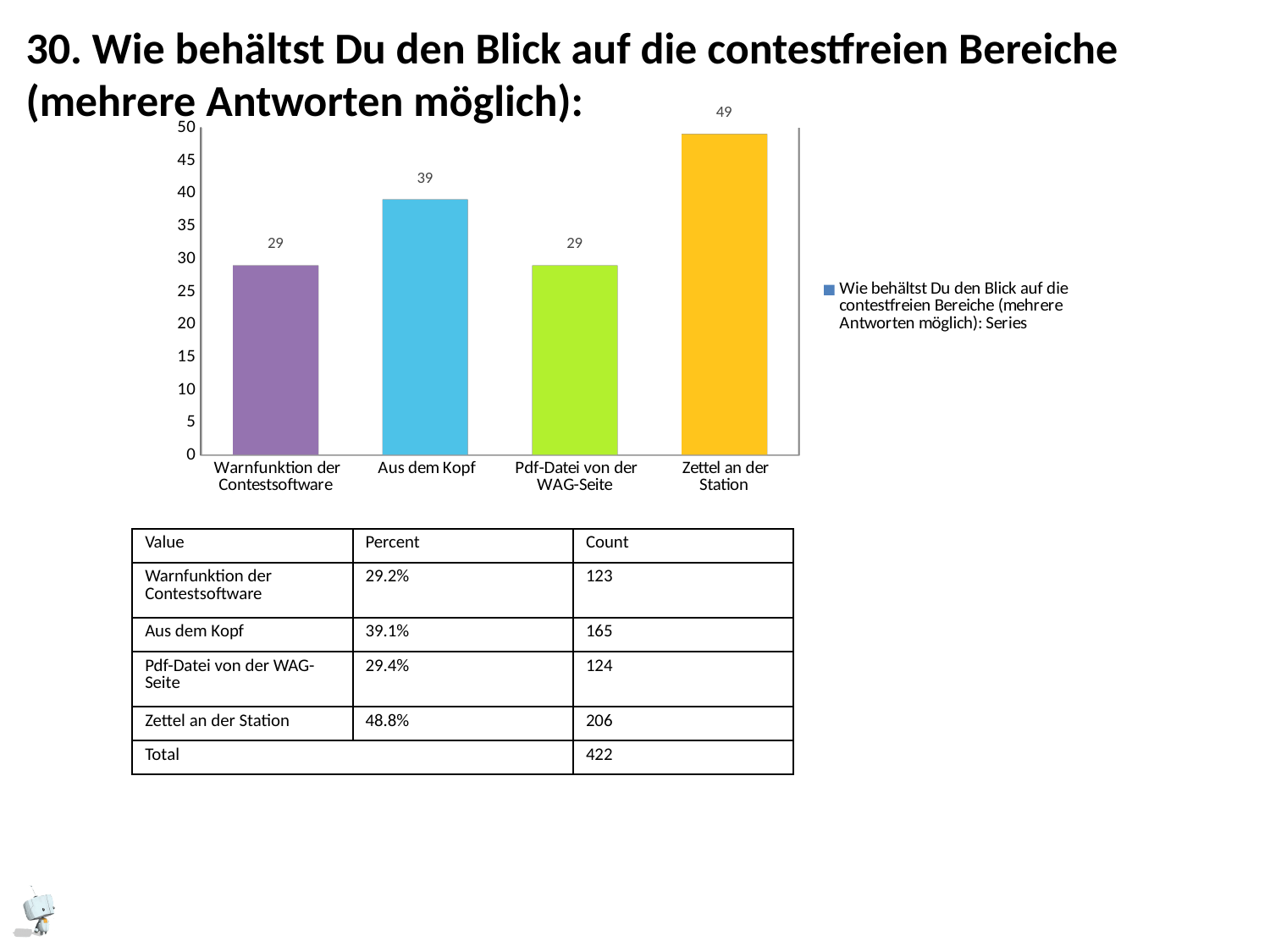
Which is larger, the value for "Aus dem Kopf" or the value for "Pdf-Datei von der WAG-Seite"? Aus dem Kopf What is the difference between the values for "Zettel an der Station" and "Aus dem Kopf"? 10 How many series does the chart legend list? 1 Which category has the highest value in the chart? Zettel an der Station What kind of chart is shown on the slide? bar chart Is the value for "Zettel an der Station" greater or less than 40? greater What value is shown for "Aus dem Kopf" in the chart? 39 How many categories are shown on the x axis of the chart? 4 What is the difference between the values for "Aus dem Kopf" and "Pdf-Datei von der WAG-Seite"? 10 What is the maximum value shown on the chart's vertical axis? 50 What value is shown for "Warnfunktion der Contestsoftware" in the chart? 29 What value is shown for "Zettel an der Station" in the chart? 49